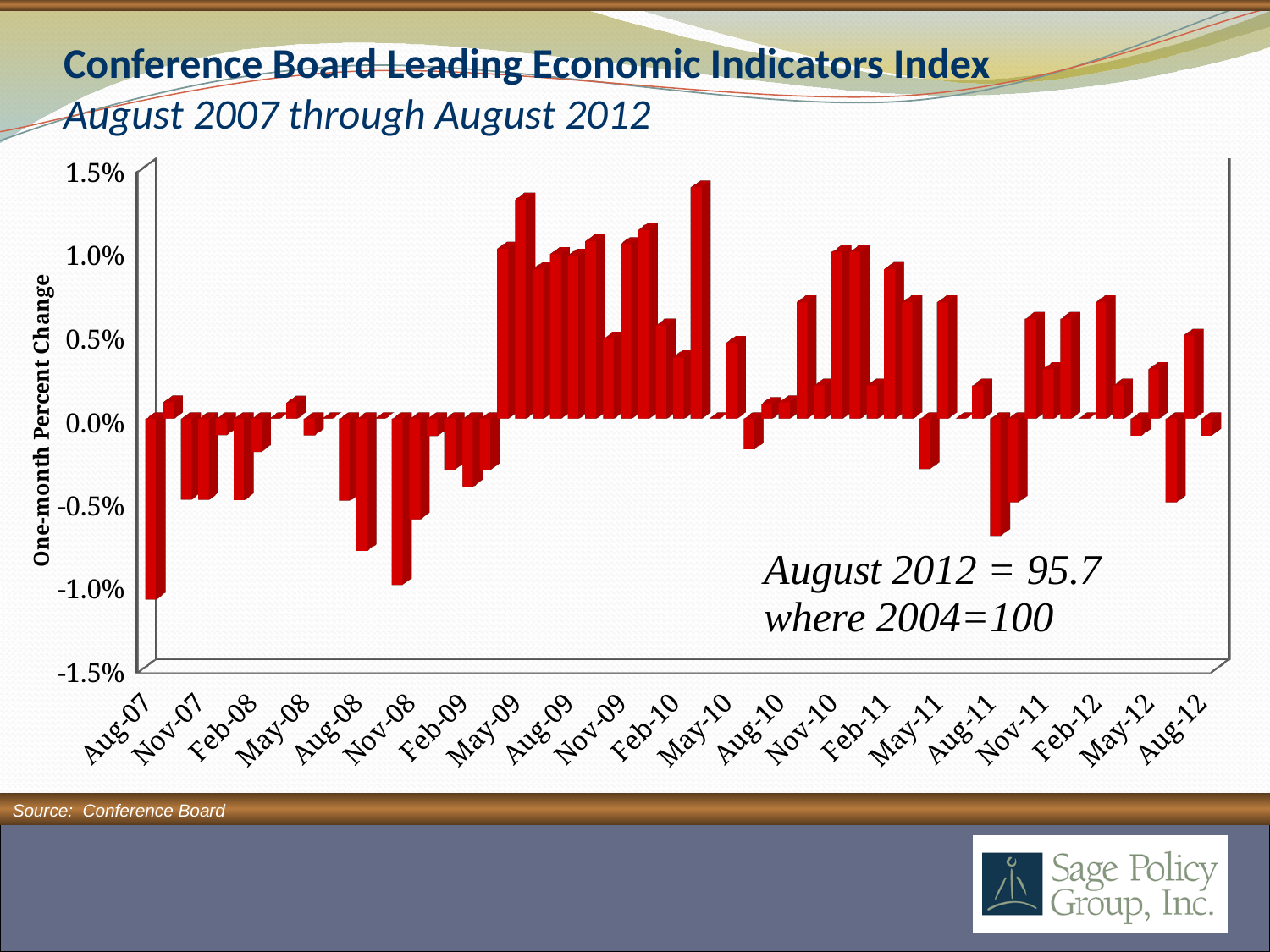
What kind of chart is shown on the slide? Bar chart According to the annotation on the chart, what was the index value in August 2012 (where 2004=100)? 95.7 What is the title of the chart? Conference Board Leading Economic Indicators Index Is the value for Aug-12 greater or less than 0.0%? less How many data series are plotted on the chart? 1 Are the one-month percent changes from Aug-07 through Feb-09 mostly positive or mostly negative? mostly negative Which is larger, the value for Aug-07 or the value for Aug-12? Aug-12 Are the one-month percent changes from May-09 through Feb-10 positive or negative? positive Is the lowest bar on the chart greater or less than -0.5%? less Is the value for Aug-07 greater or less than -0.5%? less